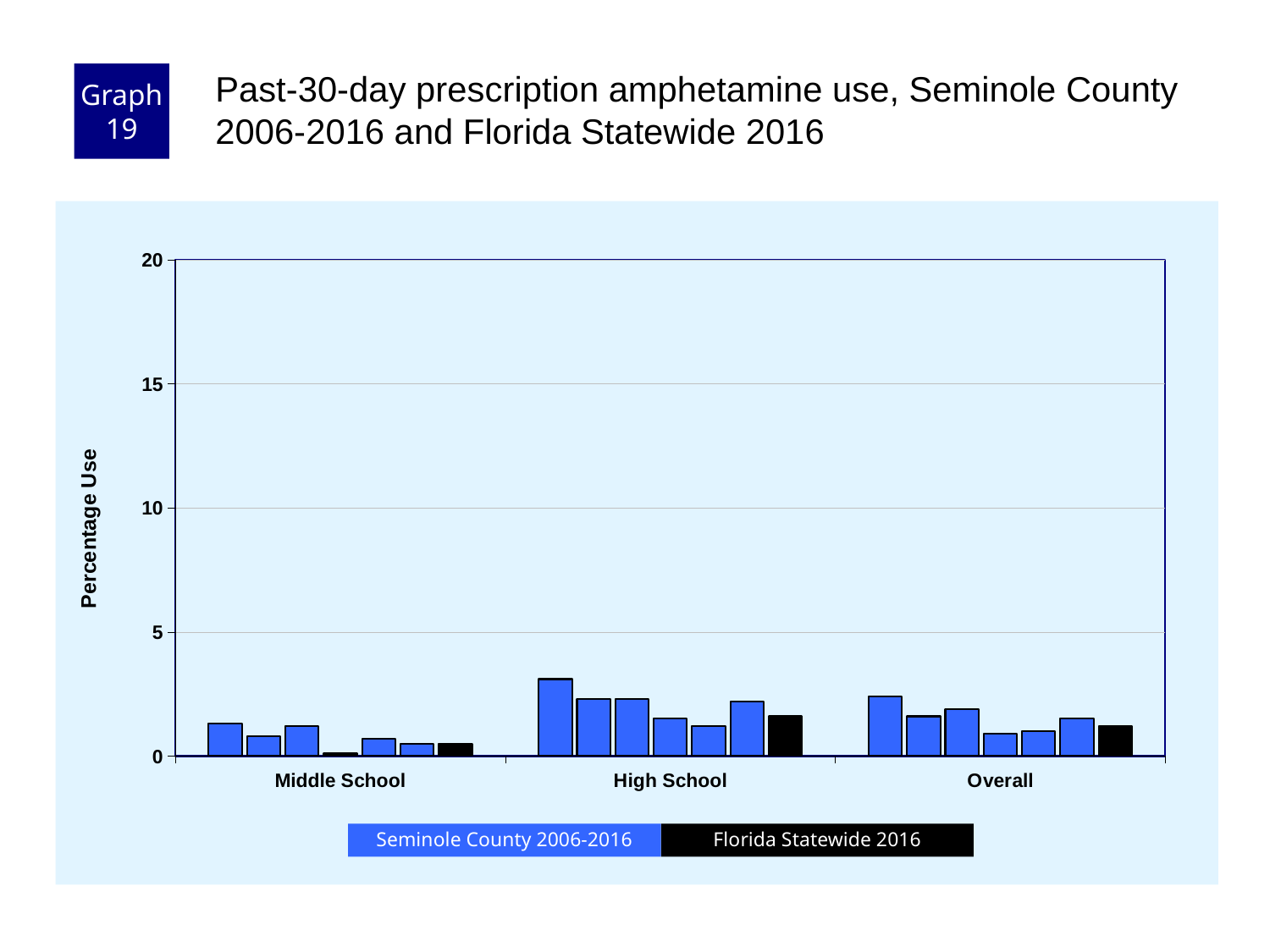
How many bars are plotted in the High School group? 7 Which is larger, the Florida Statewide 2016 bar for High School or the Florida Statewide 2016 bar for Middle School? High School Is the value for the Florida Statewide 2016 bar in the High School group greater or less than 5? less Which category contains the tallest bar on the chart? High School How many series does the legend list? 2 Is the tallest bar in the Middle School group greater or less than 5? less What kind of chart is shown on the slide? bar chart What colour are the Florida Statewide 2016 bars? black What is the label on the y axis? Percentage Use Which is larger, the Florida Statewide 2016 bar for Overall or the Florida Statewide 2016 bar for Middle School? Overall How many categories are shown on the x axis? 3 Which category contains the shortest bar on the chart? Middle School